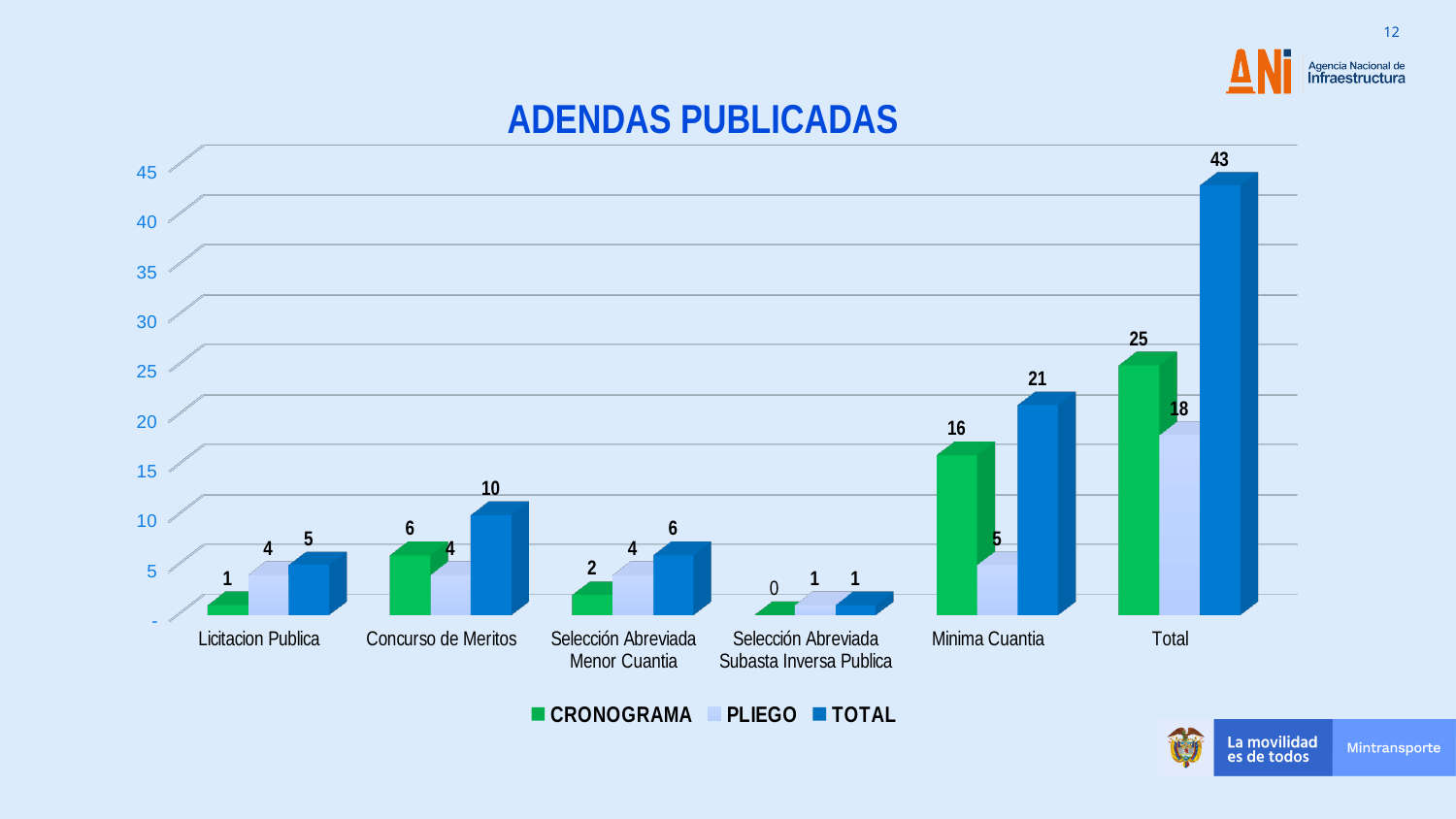
What is the CRONOGRAMA value for Selección Abreviada Subasta Inversa Publica? 0 Excluding the Total category, which category has the highest TOTAL value? Minima Cuantia What is the TOTAL value for Concurso de Meritos? 10 What is the PLIEGO value for the Total category? 18 How many series does the legend list? 3 What is the difference between the CRONOGRAMA and PLIEGO values for Minima Cuantia? 11 Which is larger for Licitacion Publica, the CRONOGRAMA value or the PLIEGO value? PLIEGO What is the CRONOGRAMA value for Minima Cuantia? 16 How many categories are shown on the x axis? 6 What kind of chart is shown on the slide? Bar chart Which category has the lowest TOTAL value? Selección Abreviada Subasta Inversa Publica What is the title of the chart? ADENDAS PUBLICADAS